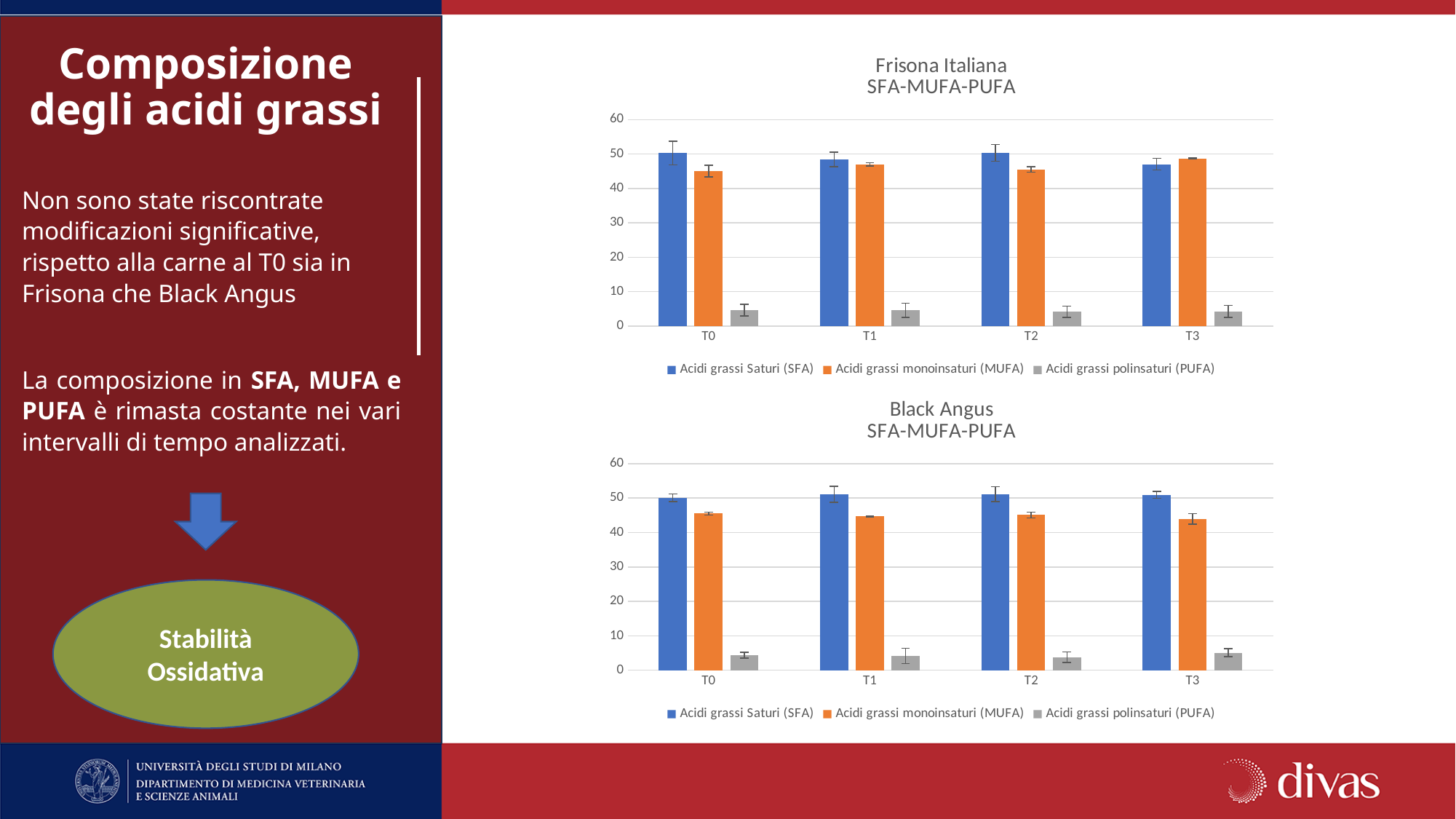
What is the title of the top chart on the slide? Frisona Italiana SFA-MUFA-PUFA In the 'Black Angus SFA-MUFA-PUFA' chart, which series has the lowest value at T0? Acidi grassi polinsaturi (PUFA) In the 'Black Angus SFA-MUFA-PUFA' chart, which is larger at T3: Acidi grassi Saturi (SFA) or Acidi grassi monoinsaturi (MUFA)? Acidi grassi Saturi (SFA) In the 'Frisona Italiana SFA-MUFA-PUFA' chart, which is larger at T0: Acidi grassi Saturi (SFA) or Acidi grassi monoinsaturi (MUFA)? Acidi grassi Saturi (SFA) What kind of chart is the 'Frisona Italiana SFA-MUFA-PUFA' chart? bar chart How many time-point categories are shown on the x axis of the 'Frisona Italiana SFA-MUFA-PUFA' chart? 4 In the 'Black Angus SFA-MUFA-PUFA' chart, which colour represents Acidi grassi monoinsaturi (MUFA)? orange How many series does the legend of the 'Black Angus SFA-MUFA-PUFA' chart list? 3 In the 'Black Angus SFA-MUFA-PUFA' chart, is the value for Acidi grassi Saturi (SFA) at T1 greater or less than 40? greater In the 'Black Angus SFA-MUFA-PUFA' chart, is the value for Acidi grassi monoinsaturi (MUFA) at T3 greater or less than 50? less In the 'Frisona Italiana SFA-MUFA-PUFA' chart, is the value for Acidi grassi polinsaturi (PUFA) at T2 greater or less than 10? less